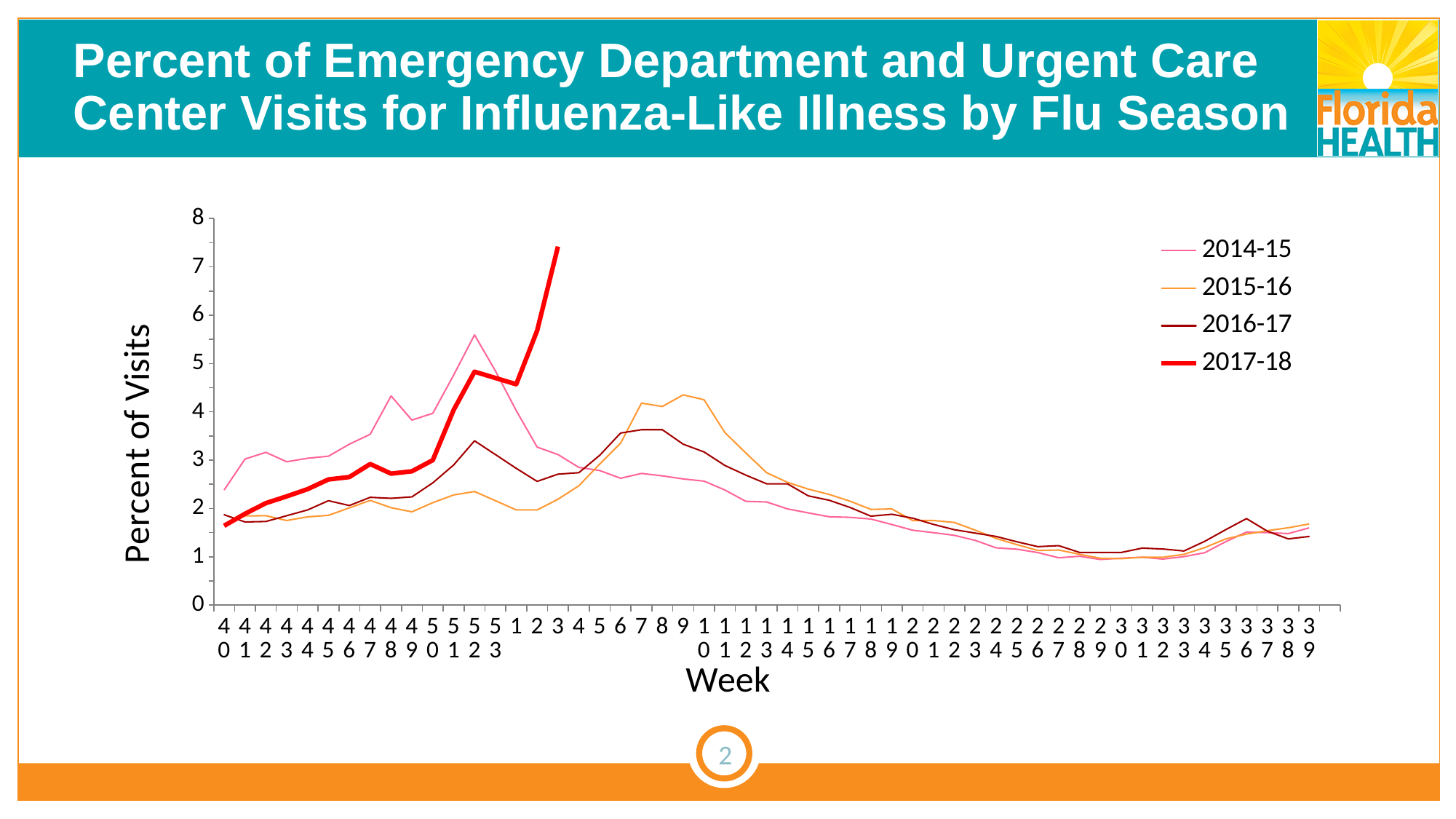
Does the 2017-18 line rise or fall from week 40 to week 3? Rise Is the value for 2017-18 at week 3 greater or less than 6? greater Is the value for 2016-17 at week 29 greater or less than 2? less Which series is drawn with the thick red line? 2017-18 How many series does the legend list? 4 At week 52, which is larger: the value for 2014-15 or the value for 2016-17? 2014-15 At week 9, which is larger: the value for 2015-16 or the value for 2014-15? 2015-16 Is the value for 2014-15 at week 52 greater or less than 5? greater Which flu season reaches the highest percent of visits on the chart? 2017-18 What kind of chart is shown on the slide? Line chart What is the label on the vertical axis? Percent of Visits